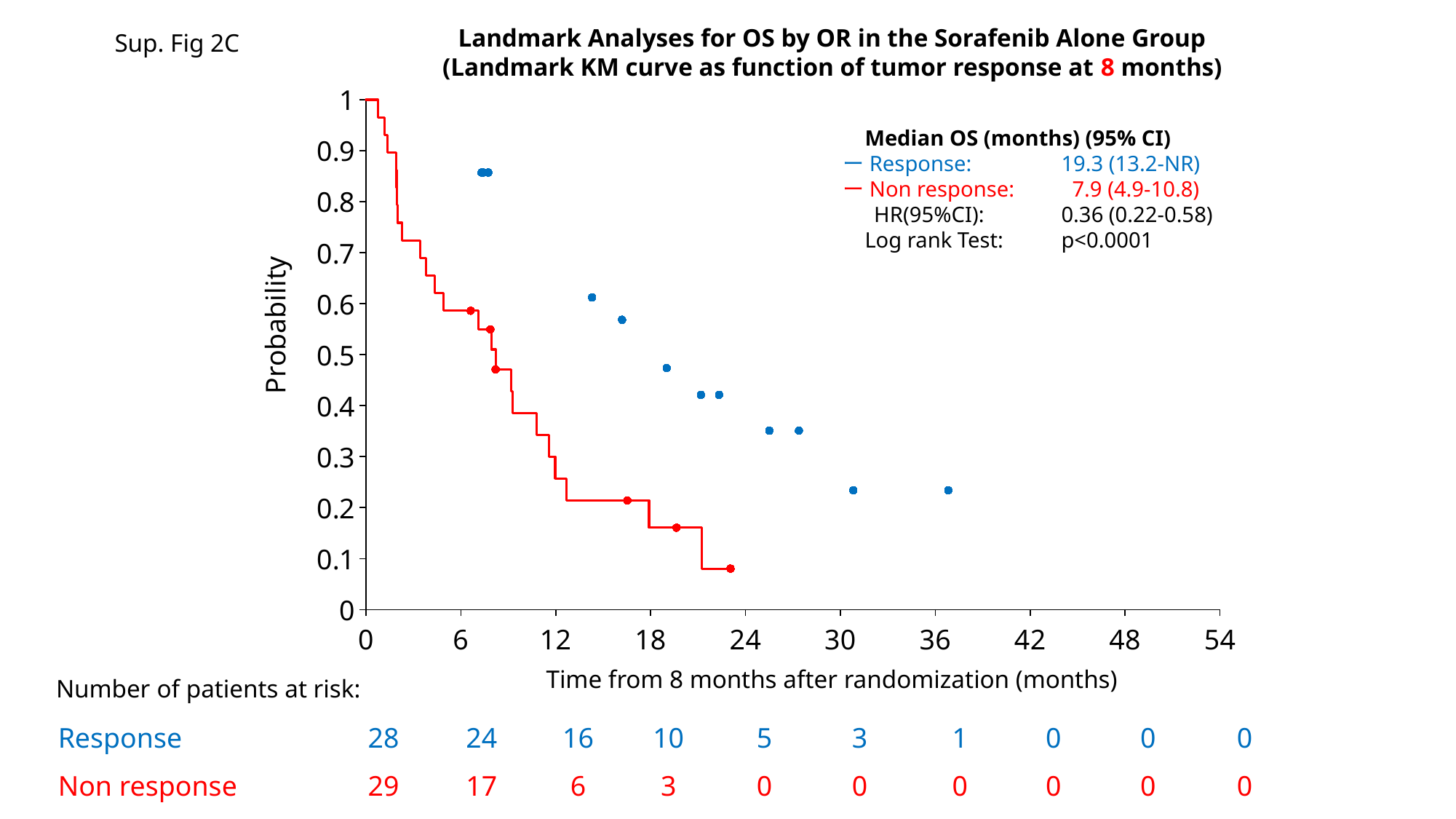
What is the log rank test p-value shown on the chart? p<0.0001 At 12 months, which group has more patients at risk, Response or Non response? Response Is the Non response survival probability at 12 months greater or less than 0.5? less How many Response patients are at risk at 12 months? 16 What is the median OS (95% CI) for the Non response group? 7.9 (4.9-10.8) What is the difference between the number of Non response and Response patients at risk at time 0? 1 What is the x-axis label of the chart? Time from 8 months after randomization (months) What is the median OS (95% CI) for the Response group? 19.3 (13.2-NR) What is the hazard ratio (95% CI) shown on the chart? 0.36 (0.22-0.58) How many groups does the legend list? 2 How many Non response patients are at risk at 6 months? 17 How many Response patients are at risk at time 0? 28